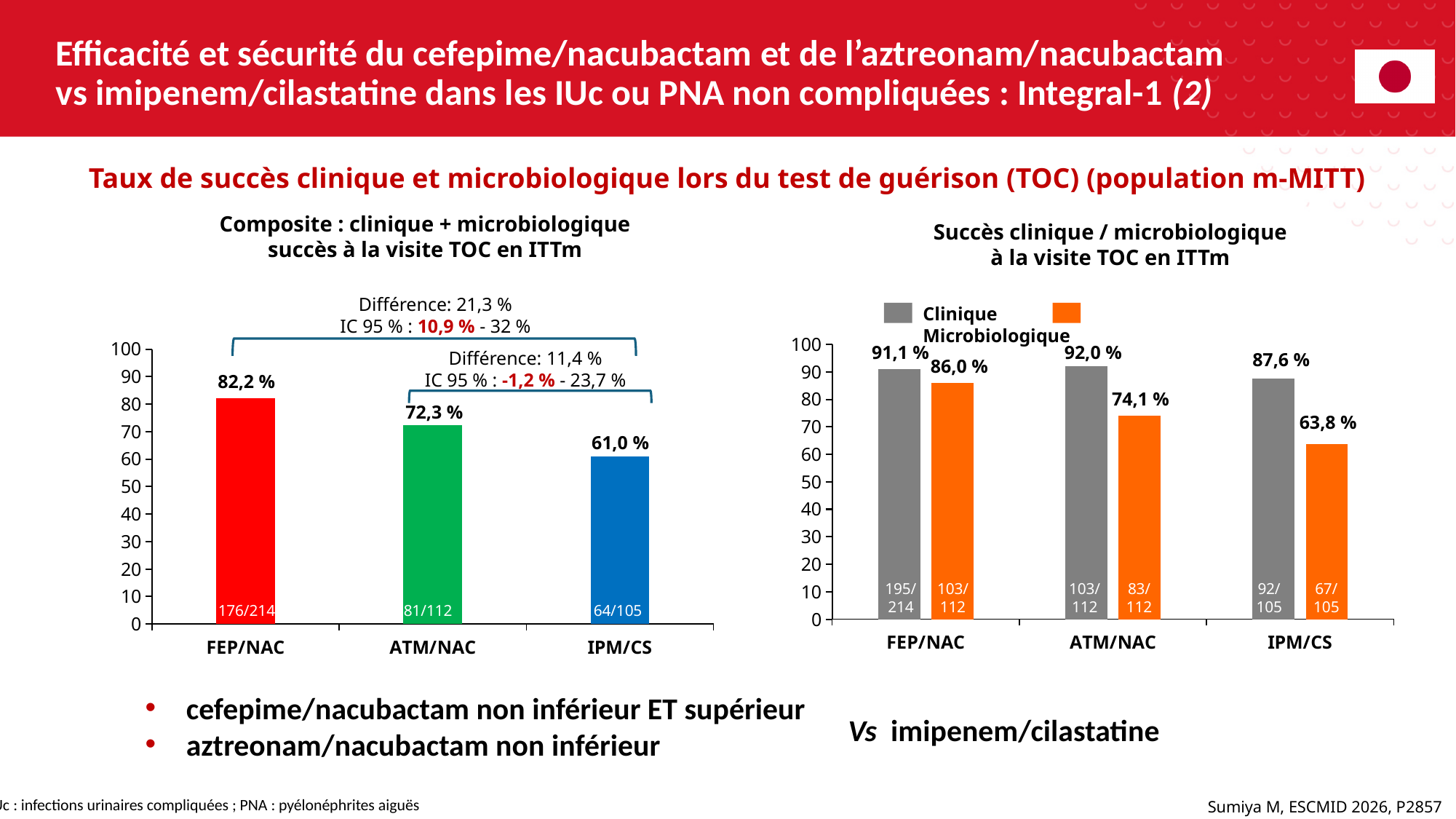
In the right chart (Succès clinique / microbiologique), which category has the lowest Microbiologique value? IPM/CS In the right chart (Succès clinique / microbiologique), what is the difference between the Clinique and Microbiologique values for IPM/CS? 23,8 % In the left chart (Composite : clinique + microbiologique), how many categories are shown on the x axis? 3 In the right chart (Succès clinique / microbiologique), what is the Microbiologique value for ATM/NAC? 74,1 % In the left chart (Composite : clinique + microbiologique), what is the difference between the FEP/NAC and IPM/CS values? 21,2 % In the left chart (Composite : clinique + microbiologique), what fraction is printed inside the ATM/NAC bar? 81/112 What kind of chart is the left chart (Composite : clinique + microbiologique)? bar chart In the right chart (Succès clinique / microbiologique), how many series does the legend list? 2 In the right chart (Succès clinique / microbiologique), which category has the highest Clinique value? ATM/NAC In the right chart (Succès clinique / microbiologique), is the Microbiologique value for FEP/NAC larger or smaller than the Microbiologique value for ATM/NAC? larger In the left chart (Composite : clinique + microbiologique), which category has the lowest value? IPM/CS In the left chart (Composite : clinique + microbiologique), what is the value for FEP/NAC? 82,2 %